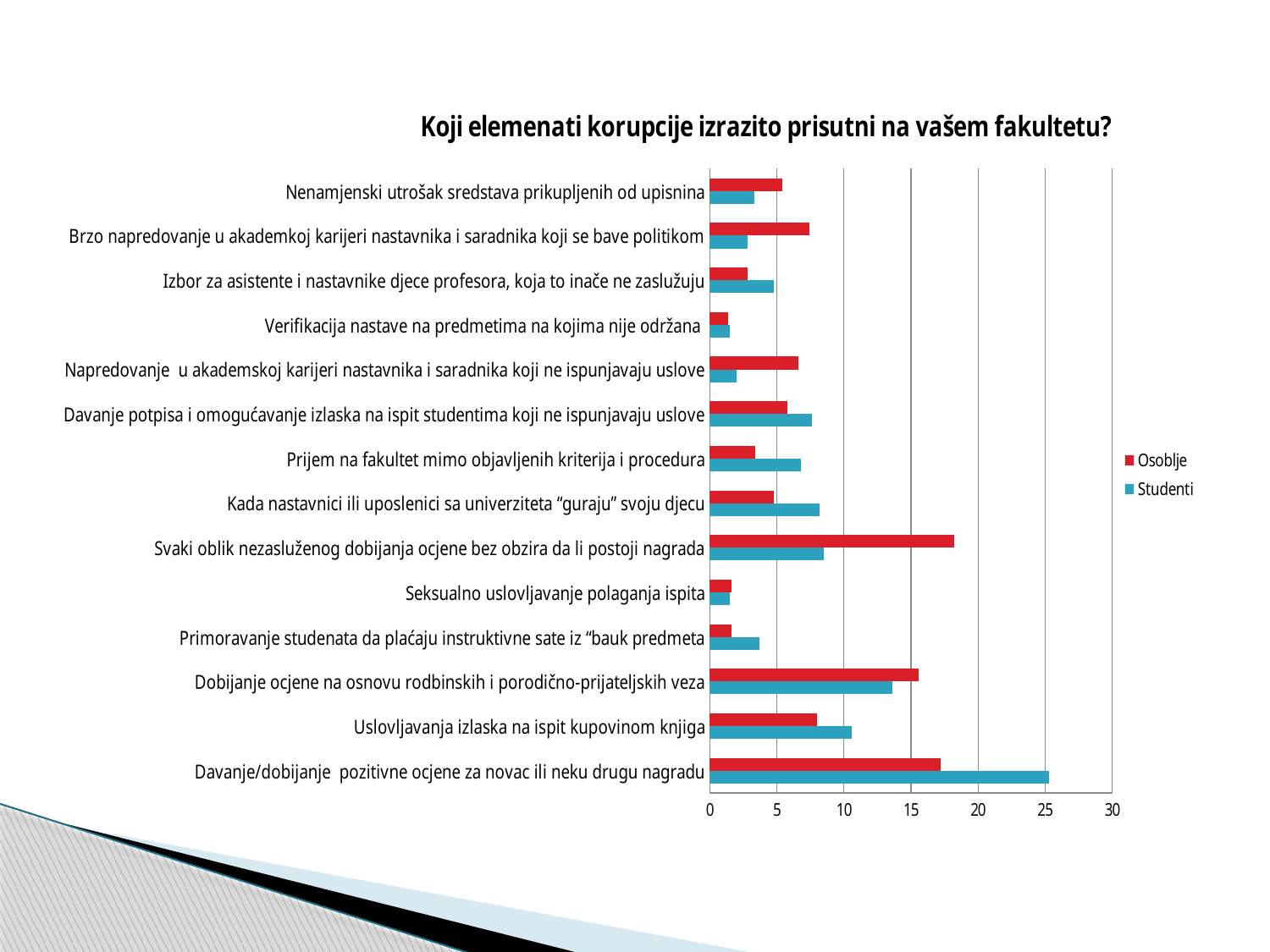
For "Kada nastavnici ili uposlenici sa univerziteta "guraju" svoju djecu", which series has the larger value, Osoblje or Studenti? Studenti What kind of chart is shown on the slide? Bar chart Is the Studenti value for "Davanje/dobijanje pozitivne ocjene za novac ili neku drugu nagradu" greater or less than 20? greater For "Svaki oblik nezasluženog dobijanja ocjene bez obzira da li postoji nagrada", which series has the larger value, Osoblje or Studenti? Osoblje Is the Studenti value for "Dobijanje ocjene na osnovu rodbinskih i porodično-prijateljskih veza" greater or less than 15? less Is the Osoblje value for "Uslovljavanja izlaska na ispit kupovinom knjiga" greater or less than 10? less What is the title of the chart? Koji elemenati korupcije izrazito prisutni na vašem fakultetu? How many series does the legend list? 2 For "Brzo napredovanje u akademkoj karijeri nastavnika i saradnika koji se bave politikom", which series has the larger value, Osoblje or Studenti? Osoblje How many categories are plotted on the chart? 14 Which category has the highest Studenti value? Davanje/dobijanje pozitivne ocjene za novac ili neku drugu nagradu